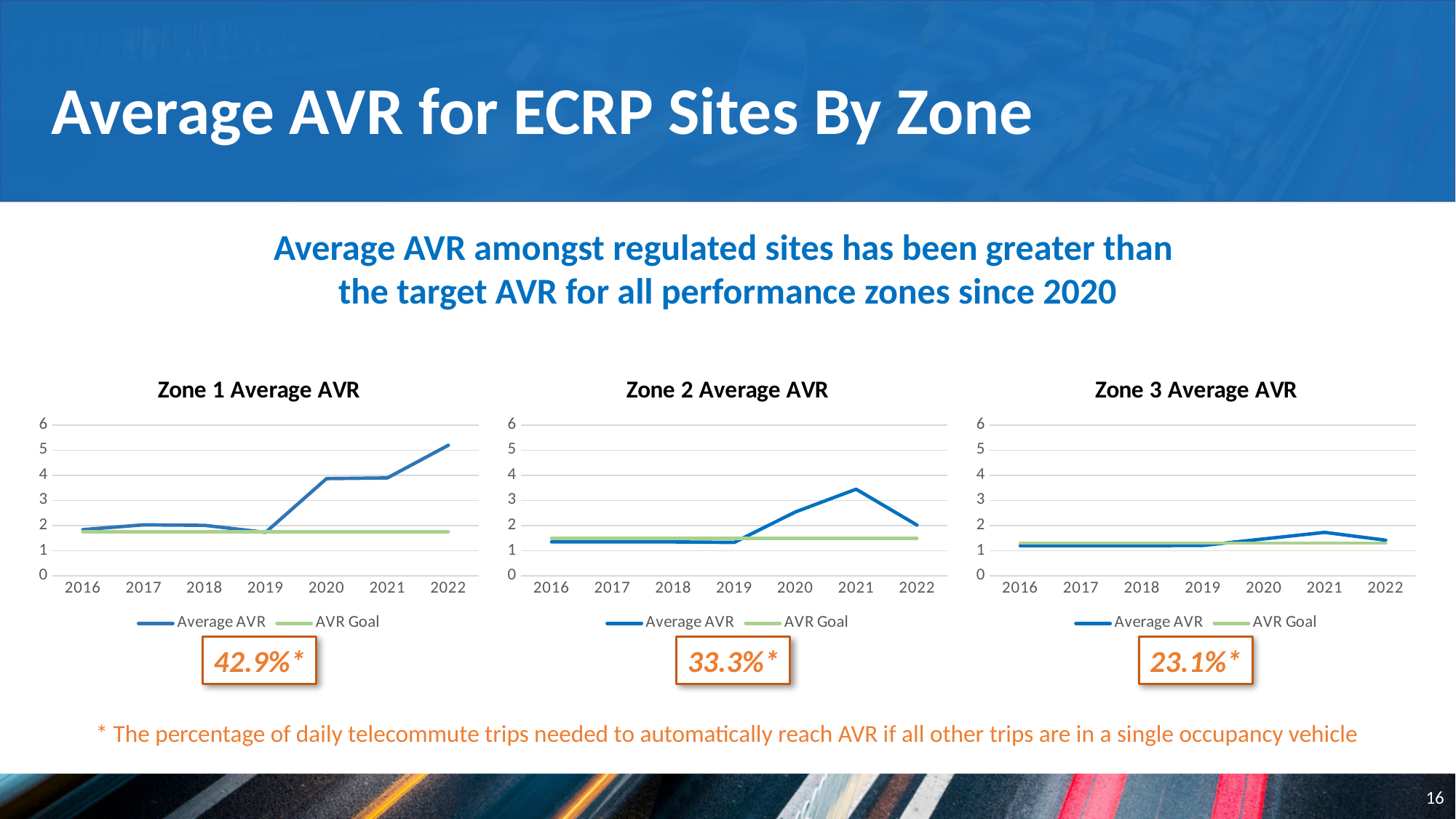
How many years are plotted on the x axis of the Zone 3 Average AVR chart? 7 In the Zone 2 Average AVR chart, is the Average AVR for 2021 greater or less than 3? greater What kind of chart is the Zone 1 Average AVR chart? line chart In the Zone 3 Average AVR chart, is the Average AVR for 2021 greater or less than 2? less In the Zone 3 Average AVR chart, which year has the highest Average AVR? 2021 In the Zone 1 Average AVR chart, does the Average AVR line generally rise or fall from 2019 to 2022? rise In the Zone 1 Average AVR chart, which year has the highest Average AVR? 2022 In the Zone 1 Average AVR chart, which is larger: the Average AVR for 2022 or for 2016? 2022 What are the two legend entries in the Zone 3 Average AVR chart? Average AVR and AVR Goal In the Zone 2 Average AVR chart, which year has the highest Average AVR? 2021 In the Zone 1 Average AVR chart, is the Average AVR for 2022 greater or less than 4? greater How many series does the legend of the Zone 2 Average AVR chart list? 2